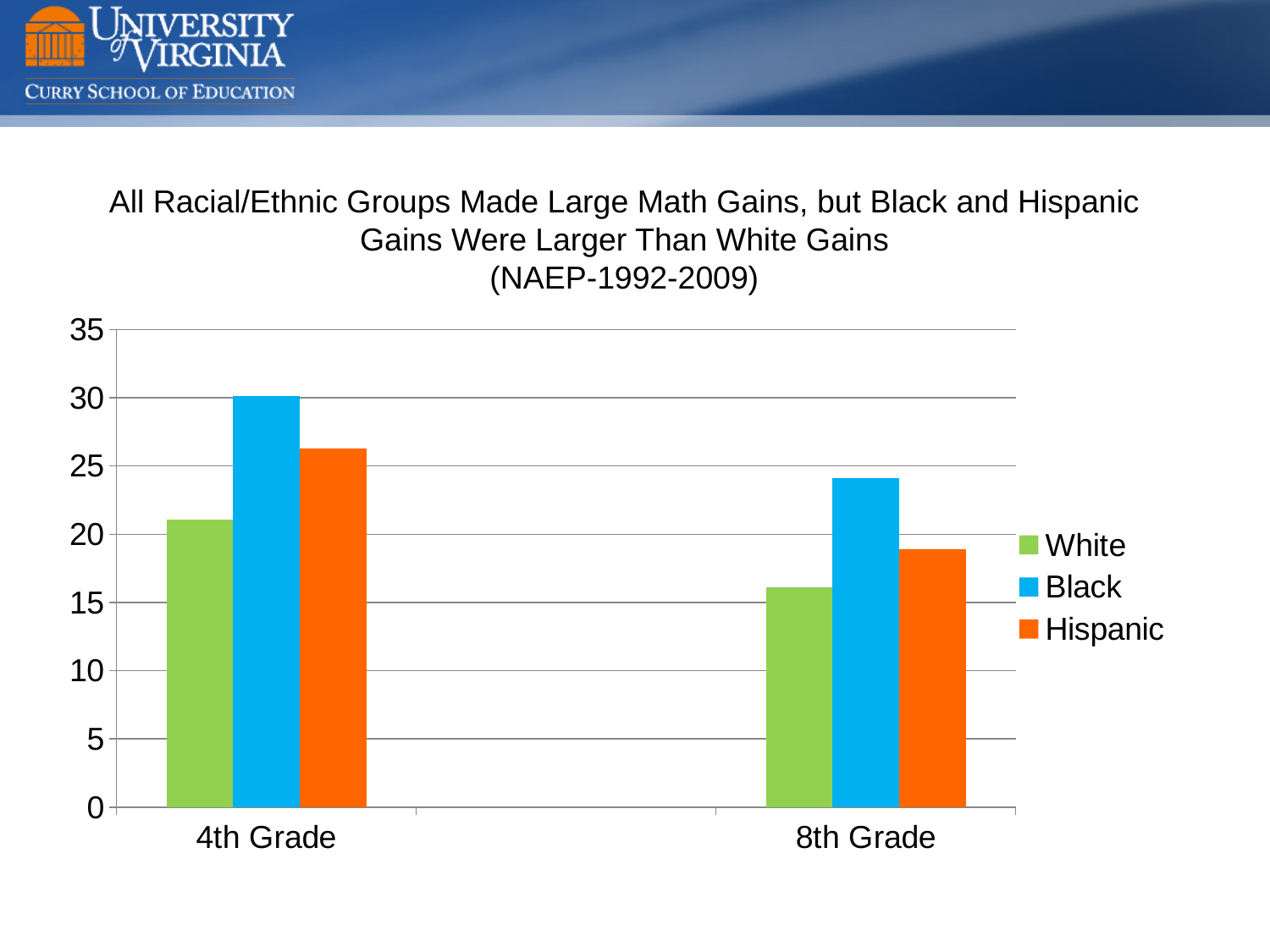
How many grade-level categories are shown on the x axis? 2 Is the value for Black in 8th Grade greater or less than 20? greater What kind of chart is shown on the slide? bar chart Is the value for White in 8th Grade greater or less than 20? less How many series does the legend list? 3 What colour represents Hispanic in the legend? orange Which group has the lowest bar for 8th Grade? White Is the Hispanic bar larger for 4th Grade or for 8th Grade? 4th Grade Is the value for Hispanic in 4th Grade greater or less than 20? greater Which is larger for 8th Grade, the Black bar or the Hispanic bar? Black Which group has the highest bar for 4th Grade? Black